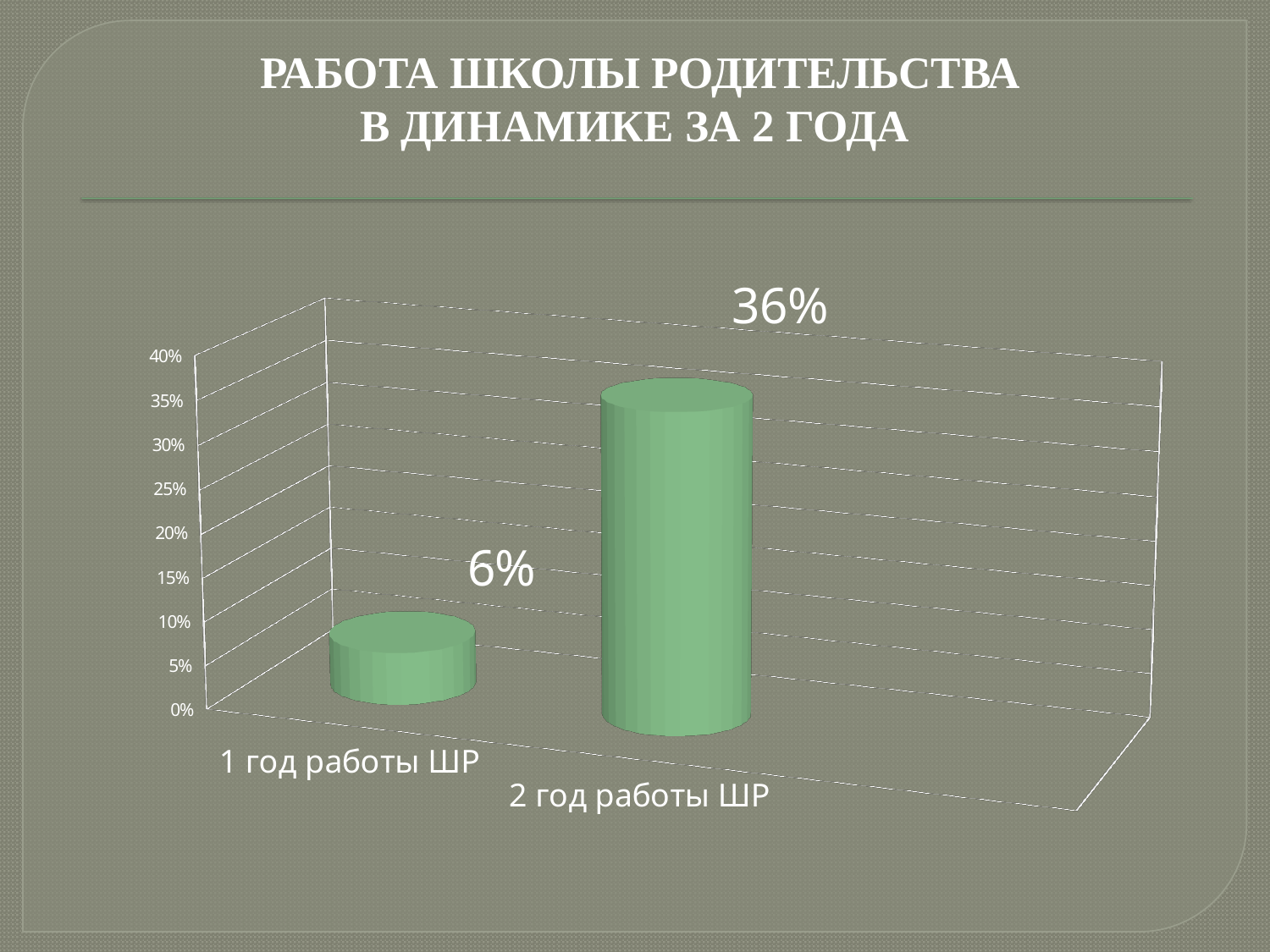
What is the value for "2 год работы ШР"? 36% Which category has the highest value? 2 год работы ШР Is the value for "1 год работы ШР" greater or less than 10%? less Do the values rise or fall from the first year to the second year? rise What is the title of the slide? РАБОТА ШКОЛЫ РОДИТЕЛЬСТВА В ДИНАМИКЕ ЗА 2 ГОДА What is the difference between the values for "2 год работы ШР" and "1 год работы ШР"? 30% What kind of chart is shown on the slide? bar chart Which is larger, the value for "1 год работы ШР" or "2 год работы ШР"? 2 год работы ШР Which category has the lowest value? 1 год работы ШР Is the value for "2 год работы ШР" greater or less than 30%? greater How many categories are shown on the chart? 2 What is the value for "1 год работы ШР"? 6%